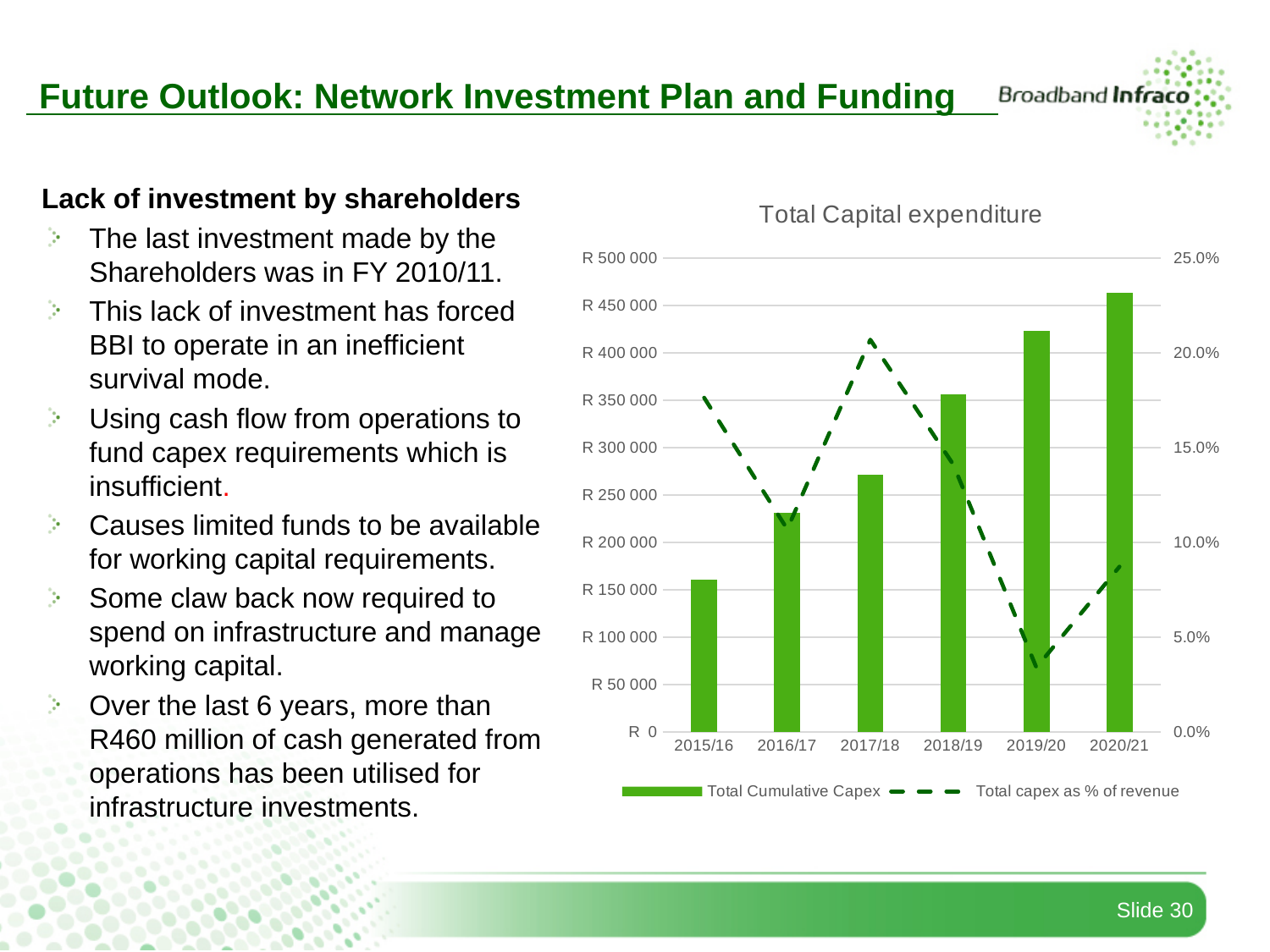
How many financial years are shown on the x axis? 6 Which year has the highest Total capex as % of revenue? 2017/18 Which year has the lowest Total Cumulative Capex? 2015/16 Is the Total Cumulative Capex for 2019/20 greater or less than R 400 000? greater Do the Total Cumulative Capex bars rise or fall from 2015/16 to 2020/21? rise Which year has the lowest Total capex as % of revenue? 2019/20 How many series does the legend list? 2 Is the Total Cumulative Capex for 2016/17 greater or less than R 250 000? less Which is larger, the Total Cumulative Capex for 2018/19 or for 2017/18? 2018/19 Which year has the highest Total Cumulative Capex? 2020/21 What is the title of the chart? Total Capital expenditure What kind of chart is used to show Total Cumulative Capex? bar chart